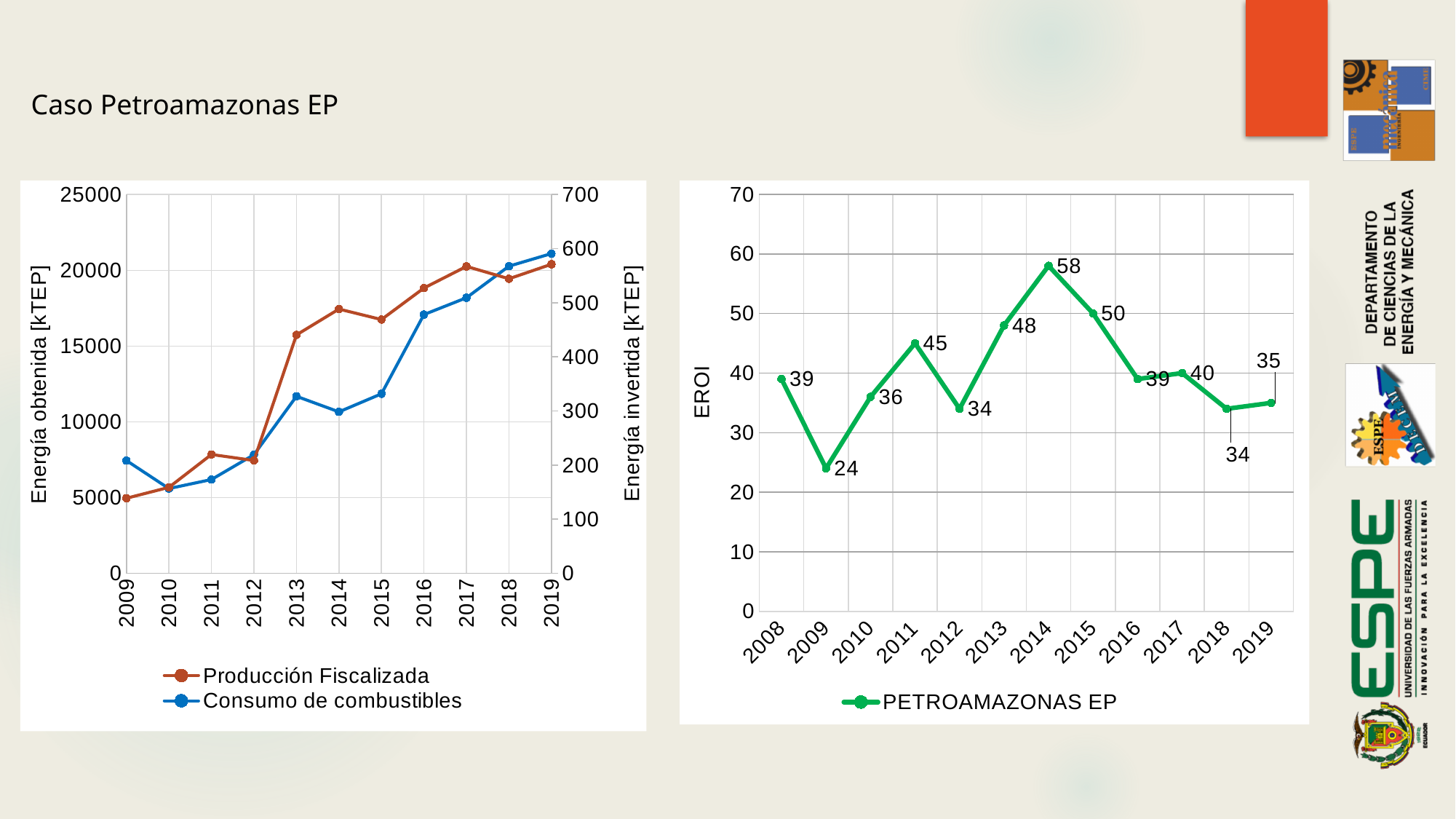
What kind of chart is the left chart? line chart In the EROI chart on the right, what is the EROI value for 2014? 58 In the EROI chart on the right, what is the difference between the EROI in 2014 and the EROI in 2015? 8 In the EROI chart on the right, which year has a higher EROI, 2011 or 2013? 2013 In the EROI chart on the right, what is the EROI value for 2019? 35 In the left chart, is the Consumo de combustibles value for 2019 greater or less than 500? greater In the left chart, how many series does the legend list? 2 In the EROI chart on the right, which year has the highest EROI? 2014 In the EROI chart on the right, what is the EROI value for 2009? 24 In the left chart, is the Producción Fiscalizada value for 2013 greater or less than 15000? greater In the EROI chart on the right, how many years are plotted? 12 In the EROI chart on the right, which year has the lowest EROI? 2009